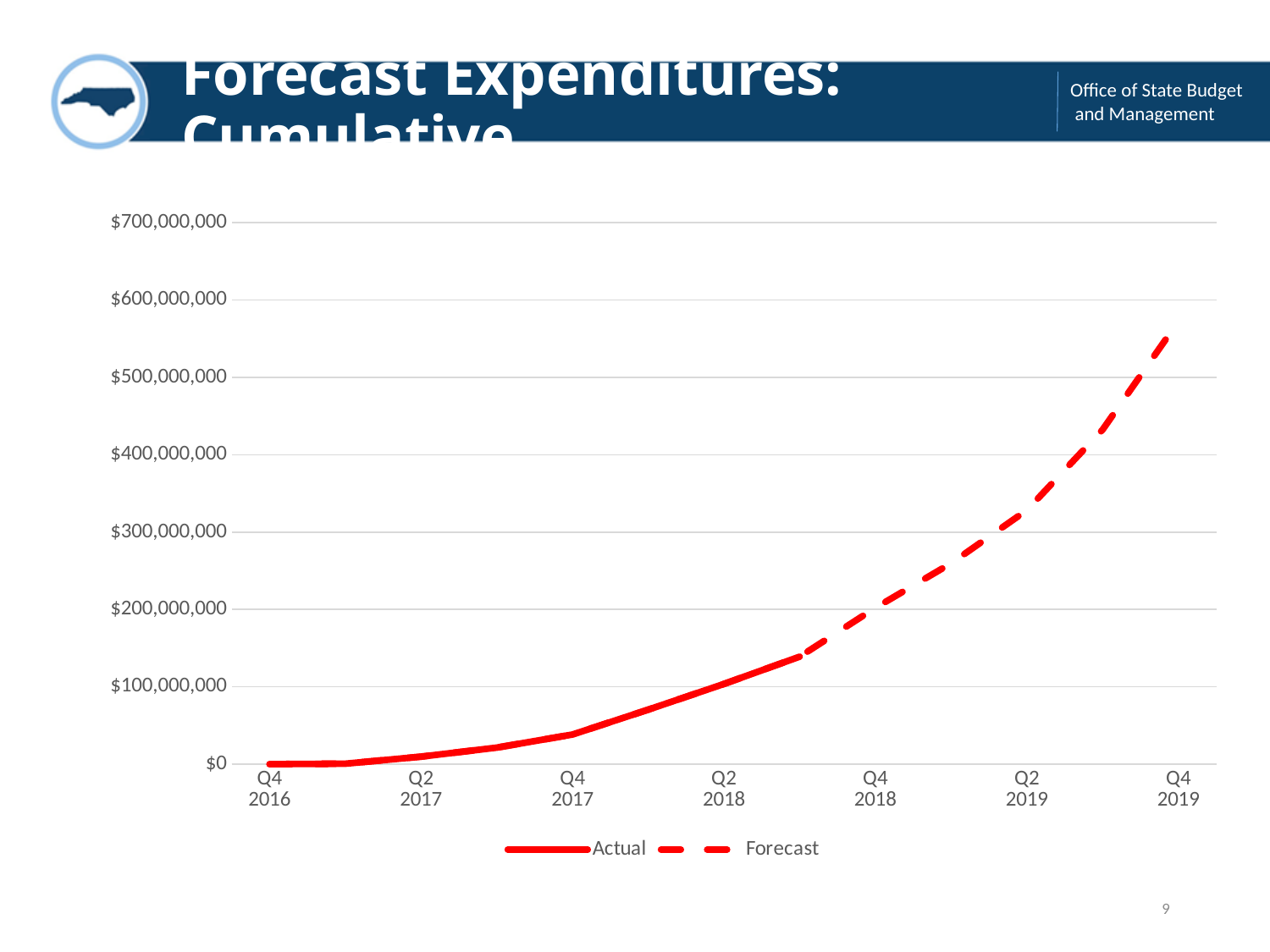
Do the values rise or fall from Q4 2016 to Q4 2019? rise What are the two series named in the legend? Actual and Forecast How many quarter labels are shown on the x axis? 7 Is the Actual value at Q4 2017 greater or less than $100,000,000? less Is the Forecast value at Q4 2019 greater or less than $500,000,000? greater Is the Actual value at Q4 2016 greater or less than $100,000,000? less How many series does the legend list? 2 Which series is drawn with a dashed line? Forecast Which quarter has the highest value on the chart? Q4 2019 What kind of chart is shown on the slide? line chart